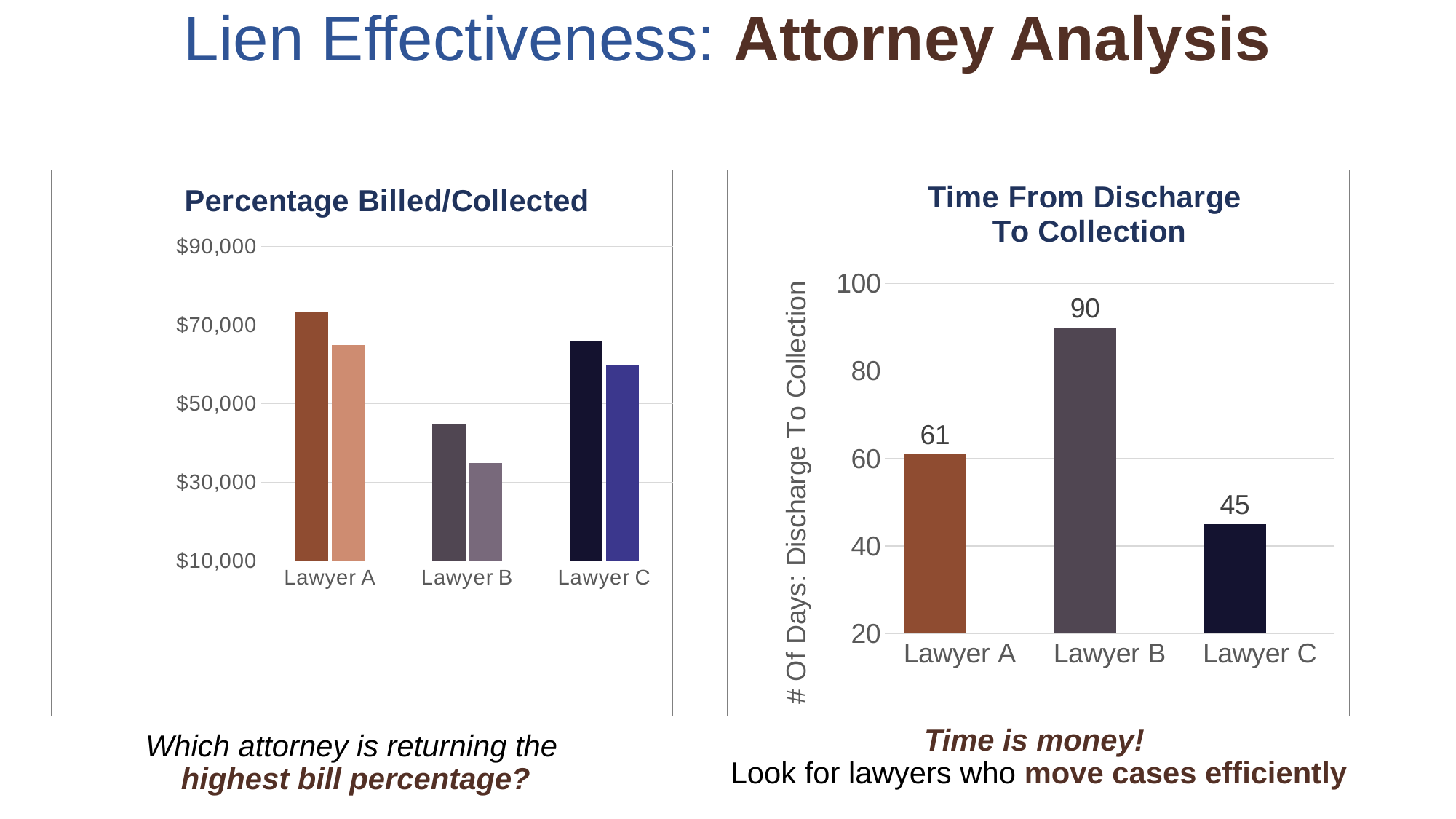
What is the y-axis label of the 'Time From Discharge To Collection' chart? # Of Days: Discharge To Collection In the 'Time From Discharge To Collection' chart, which is larger, the value for Lawyer A or Lawyer C? Lawyer A In the 'Percentage Billed/Collected' chart, is the taller bar for Lawyer B greater or less than $50,000? less In the 'Percentage Billed/Collected' chart, which lawyer has the tallest bar? Lawyer A In the 'Percentage Billed/Collected' chart, is the taller bar for Lawyer A greater or less than $70,000? greater How many lawyers are shown in the 'Time From Discharge To Collection' chart? 3 What kind of chart is the 'Percentage Billed/Collected' chart? bar chart In the 'Time From Discharge To Collection' chart, what is the difference between Lawyer B and Lawyer C? 45 In the 'Time From Discharge To Collection' chart, what is the value for Lawyer B? 90 In the 'Time From Discharge To Collection' chart, which lawyer has the lowest value? Lawyer C In the 'Time From Discharge To Collection' chart, what is the value for Lawyer A? 61 In the 'Time From Discharge To Collection' chart, which lawyer has the highest value? Lawyer B